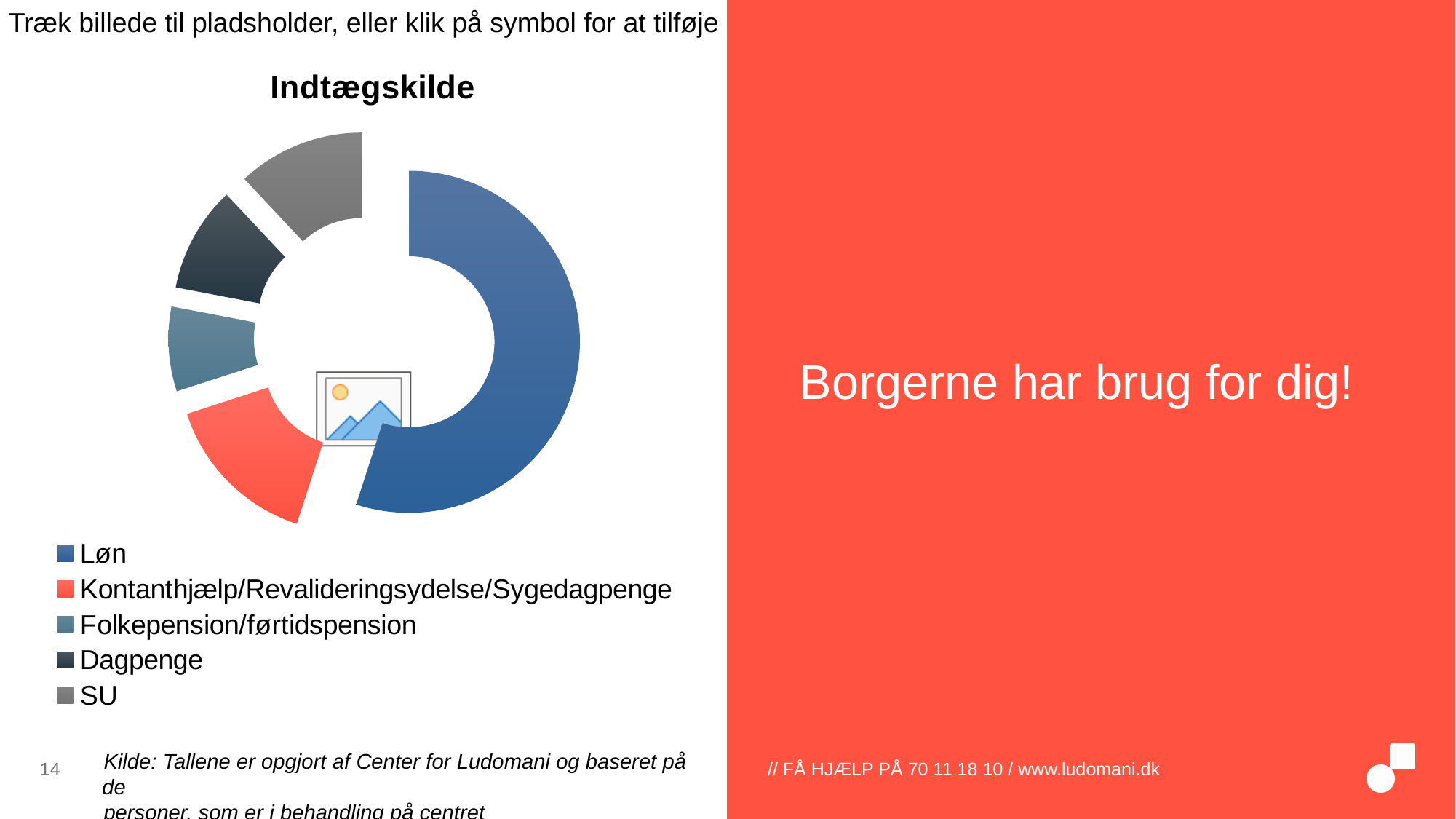
Which category has the smallest share of the chart? Folkepension/førtidspension What is the title of the chart? Indtægskilde What kind of chart is shown on the slide? Doughnut chart How many categories does the chart show? 5 Which category has the largest share of the chart? Løn Which is larger, the share for Løn or the share for SU? Løn Which is larger, the share for Løn or the share for Kontanthjælp/Revalideringsydelse/Sygedagpenge? Løn Which colour represents Løn in the chart? Blue Which is larger, the share for Dagpenge or the share for Folkepension/førtidspension? Dagpenge